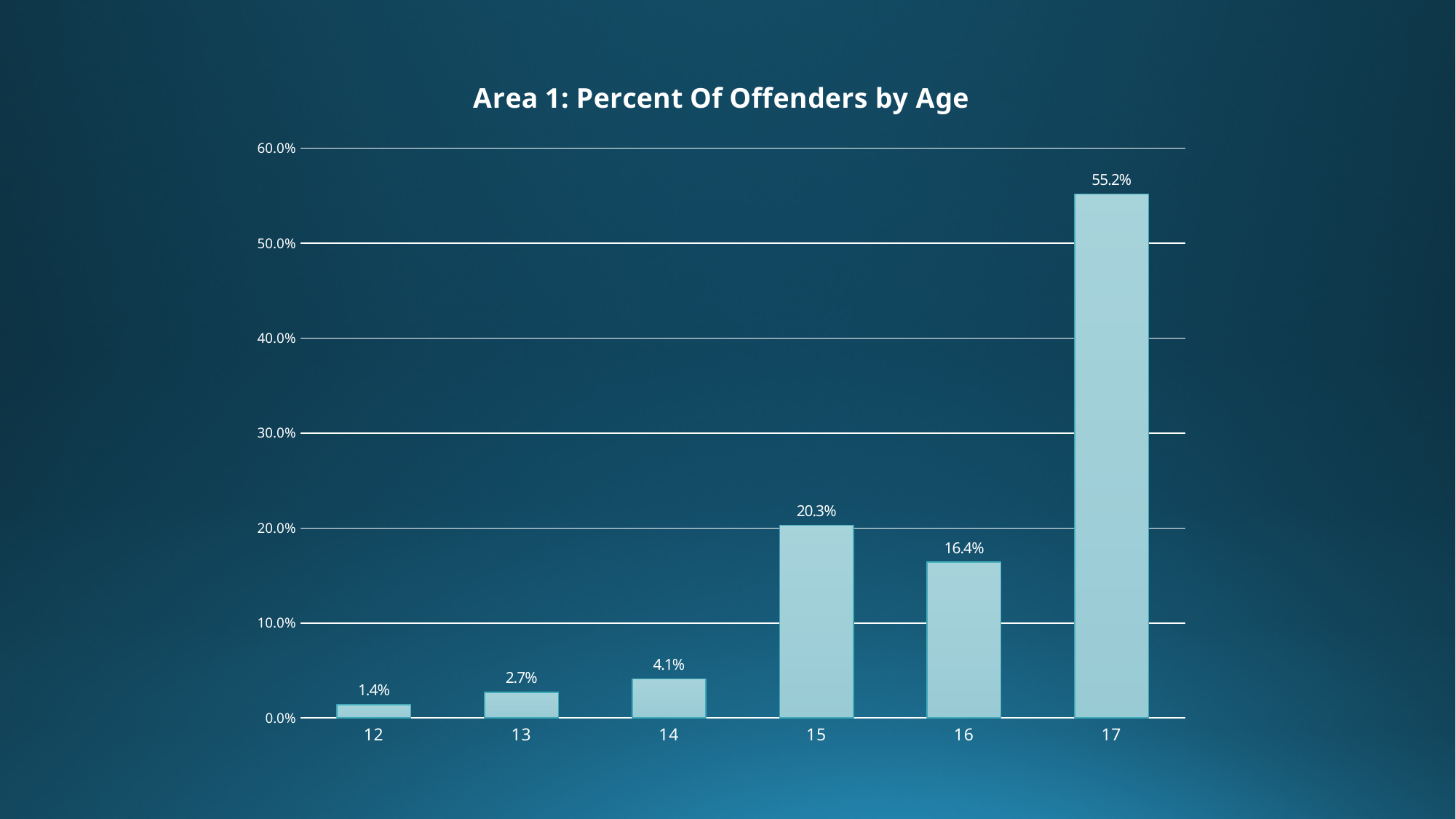
What is the percent of offenders for age 13? 2.7% What kind of chart is shown on the slide? Bar chart What is the percent of offenders for age 15? 20.3% What is the difference between the percent of offenders for age 17 and age 15? 34.9% Which age has a larger percent of offenders, 15 or 16? 15 Which age has the lowest percent of offenders? 12 Which age has the highest percent of offenders? 17 How many age categories are shown on the chart? 6 What is the percent of offenders for age 17? 55.2% What is the difference between the percent of offenders for age 16 and age 14? 12.3% Is the value for age 17 greater or less than 50.0%? greater What is the title of the chart? Area 1: Percent Of Offenders by Age